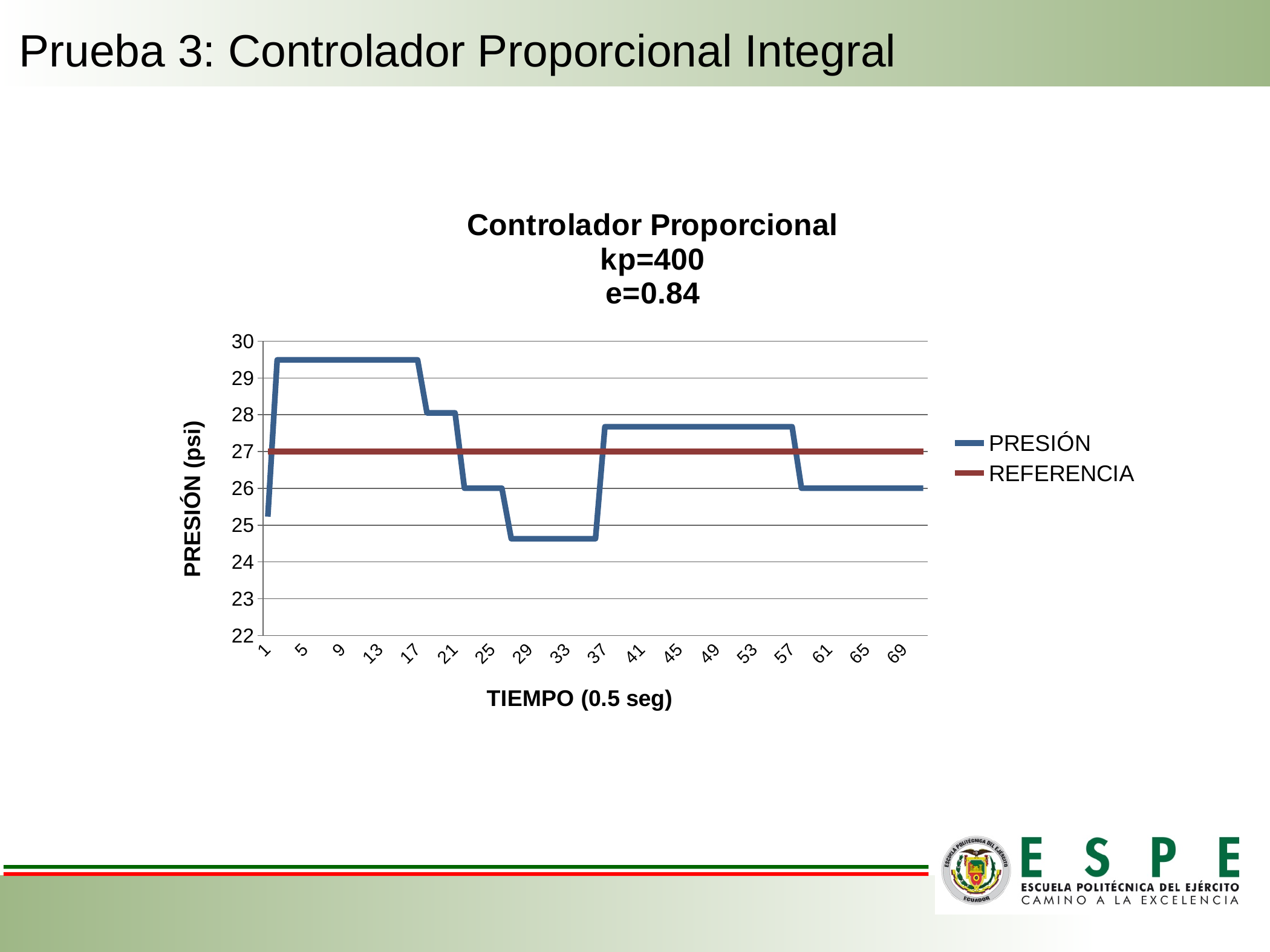
What kind of chart is shown on the slide? line chart Is the PRESIÓN value at time 65 greater or less than 27? less What are the two series named in the legend? PRESIÓN and REFERENCIA At time 33, which series has the larger value, PRESIÓN or REFERENCIA? REFERENCIA Between time 17 and time 29, does the PRESIÓN line rise or fall? fall Is the PRESIÓN value at time 45 greater or less than 27? greater What constant value does the REFERENCIA line hold across the chart? 27 Is the PRESIÓN value at time 9 greater or less than 29? greater What is the title of the x axis? TIEMPO (0.5 seg) How many series does the legend list? 2 At time 9, which series has the larger value, PRESIÓN or REFERENCIA? PRESIÓN